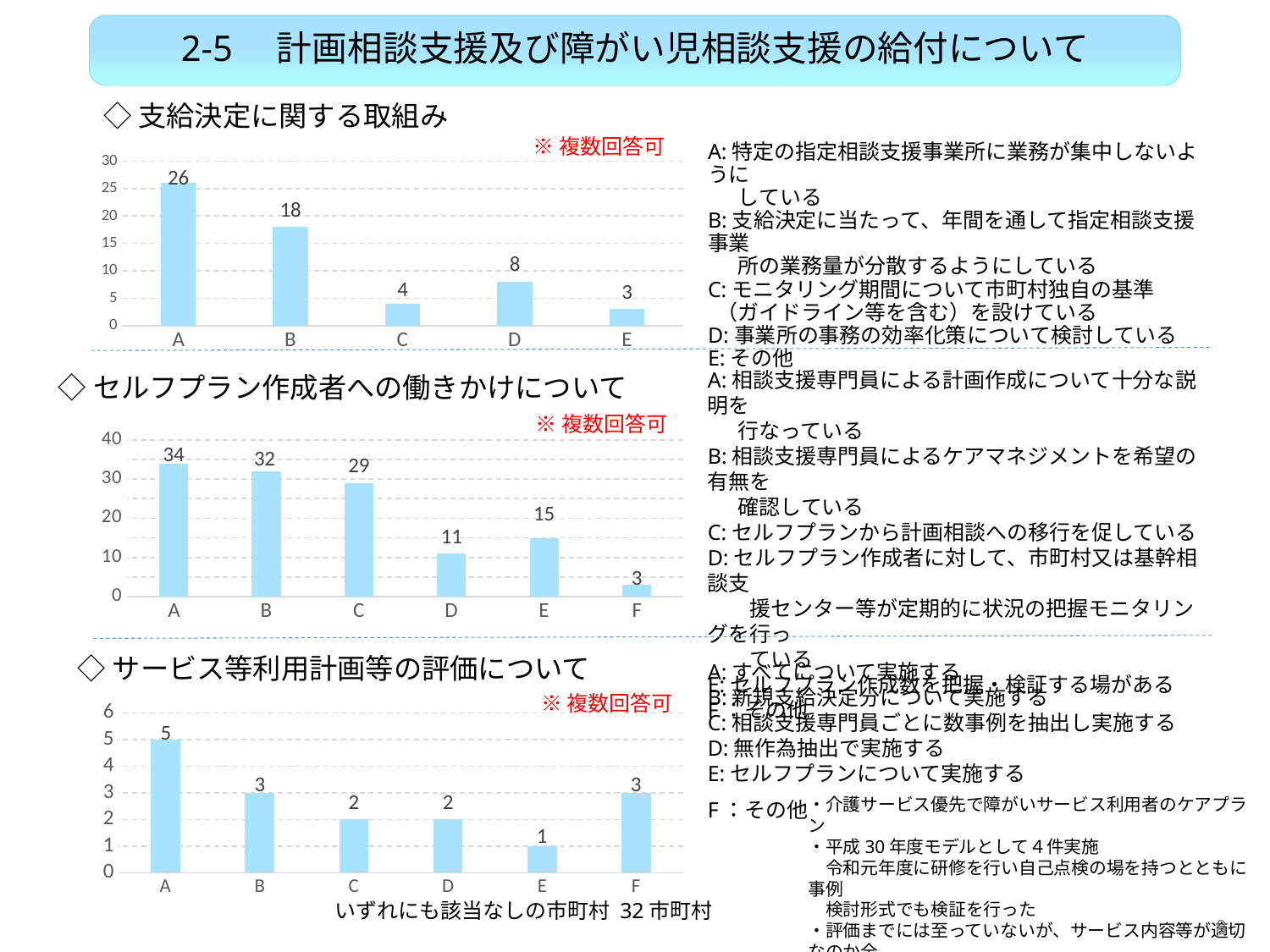
In the chart titled セルフプラン作成者への働きかけについて, what is the value for category C? 29 In the chart titled 支給決定に関する取組み, which category has the lowest value? E In the chart titled セルフプラン作成者への働きかけについて, how many categories are shown on the x axis? 6 In the chart titled セルフプラン作成者への働きかけについて, which is larger, the value for D or the value for E? E In the chart titled サービス等利用計画等の評価について, what is the value for category A? 5 In the chart titled サービス等利用計画等の評価について, what is the difference between the values for A and F? 2 In the chart titled サービス等利用計画等の評価について, which category has the lowest value? E In the chart titled 支給決定に関する取組み, how many categories are shown on the x axis? 5 In the chart titled セルフプラン作成者への働きかけについて, which category has the highest value? A In the chart titled 支給決定に関する取組み, what is the value for category A? 26 What kind of chart is the chart titled サービス等利用計画等の評価について? bar chart In the chart titled 支給決定に関する取組み, what is the difference between the values for A and B? 8